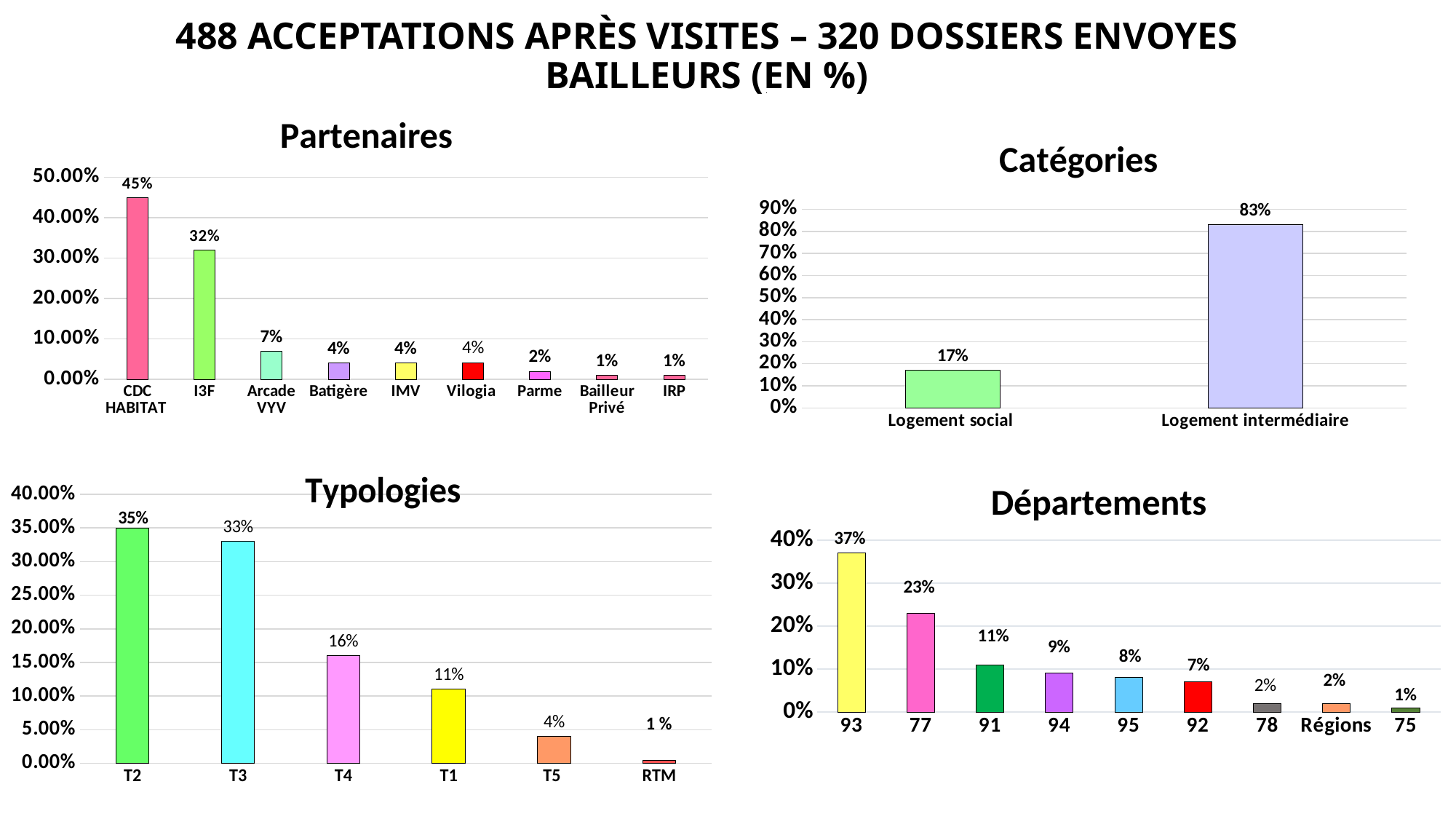
In the Typologies chart, what is the value for T4? 16% In the Départements chart, what is the value for 77? 23% In the Partenaires chart, which partner has the highest value? CDC HABITAT In the Typologies chart, which typology has the lowest value? RTM In the Partenaires chart, what is the value for I3F? 32% What kind of chart is the Typologies chart? Bar chart In the Partenaires chart, how many partners are shown? 9 In the Départements chart, how many categories are shown on the x axis? 9 In the Catégories chart, what is the value for Logement intermédiaire? 83% In the Typologies chart, which is larger, T2 or T3? T2 In the Départements chart, what is the difference between 93 and 91? 26% In the Catégories chart, what is the difference between Logement intermédiaire and Logement social? 66%